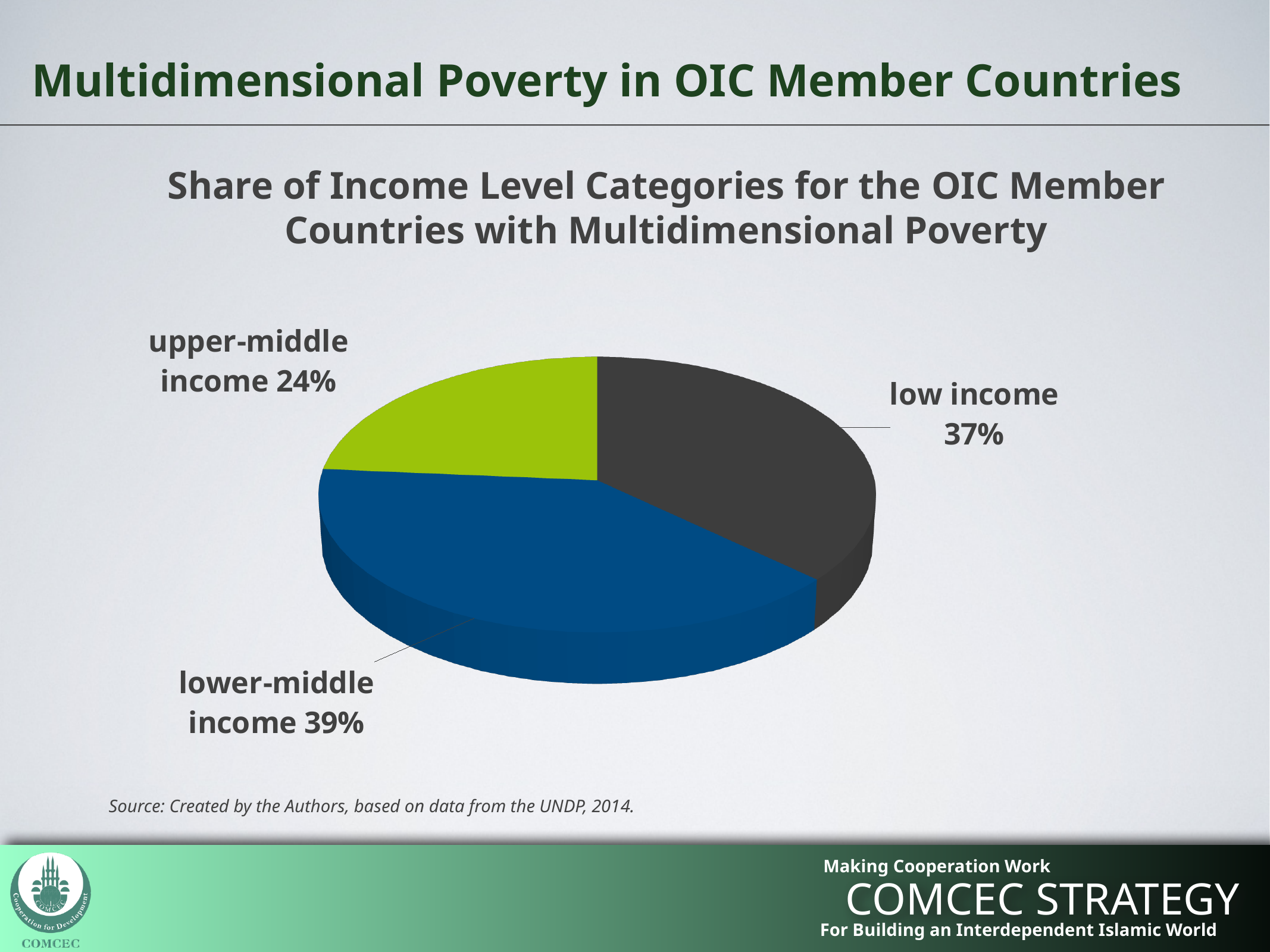
What colour is the slice for lower-middle income? blue Which is larger, the share for low income or the share for upper-middle income? low income Which income level category has the largest share of the pie? lower-middle income What is the difference in percentage points between the lower-middle income share and the upper-middle income share? 15 What kind of chart is shown on the slide? pie chart What is the difference in percentage points between the low income share and the upper-middle income share? 13 What share of the pie is labelled for upper-middle income? 24% Which income level category has the smallest share of the pie? upper-middle income What share of the pie is labelled for low income? 37% What share of the pie is labelled for lower-middle income? 39% What is the title of the chart? Share of Income Level Categories for the OIC Member Countries with Multidimensional Poverty How many income level categories are shown in the pie chart? 3